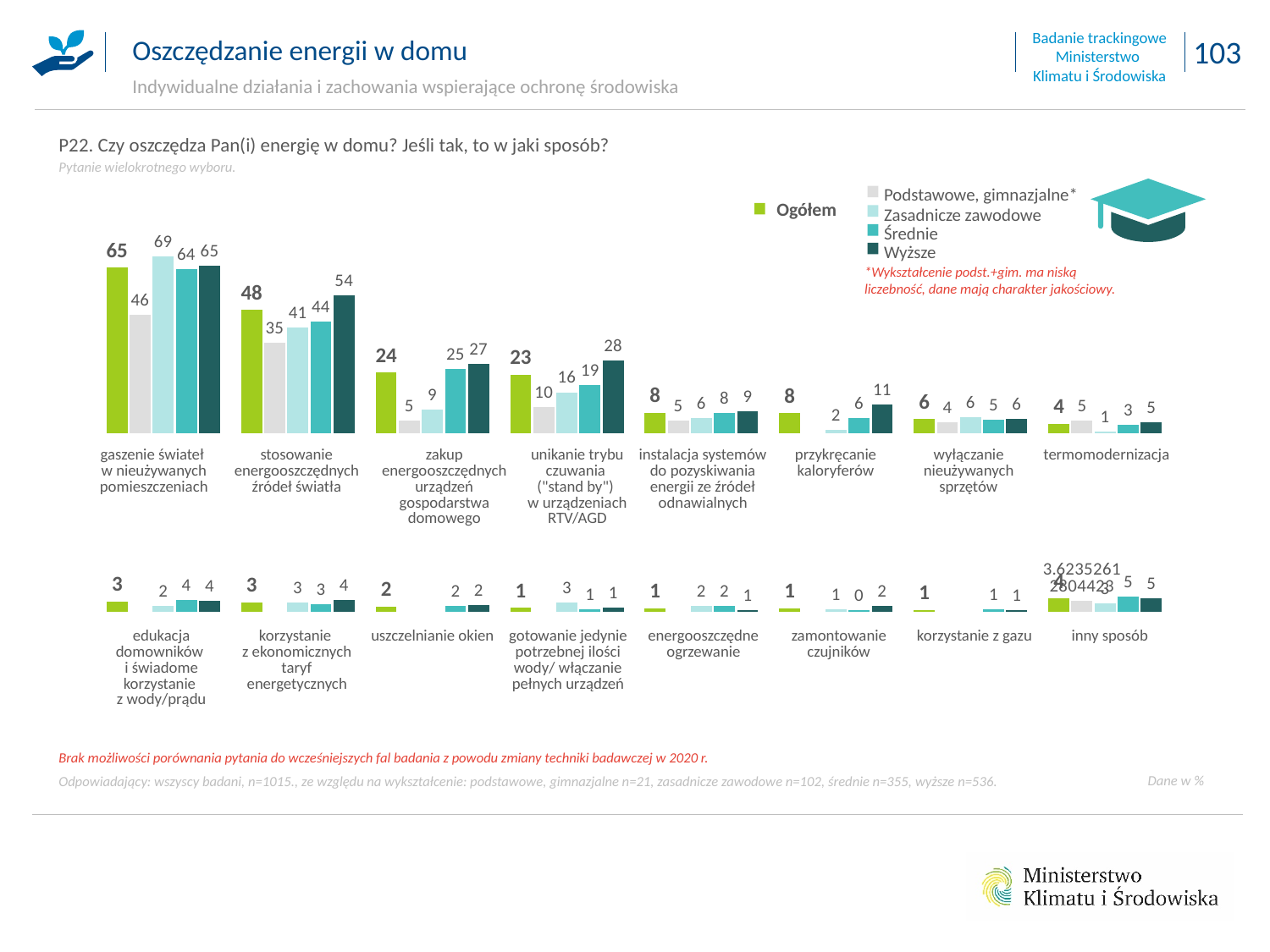
What is the Ogółem value for 'gaszenie świateł w nieużywanych pomieszczeniach'? 65 What is the difference between the Wyższe and Podstawowe, gimnazjalne values for 'stosowanie energooszczędnych źródeł światła'? 19 Which category has the highest Ogółem value? gaszenie świateł w nieużywanych pomieszczeniach What is the Wyższe value for 'stosowanie energooszczędnych źródeł światła'? 54 What is the difference between the Ogółem values for 'gaszenie świateł w nieużywanych pomieszczeniach' and 'stosowanie energooszczędnych źródeł światła'? 17 What is the Podstawowe, gimnazjalne value for 'zakup energooszczędnych urządzeń gospodarstwa domowego'? 5 What kind of chart is shown on the slide? bar chart Within 'stosowanie energooszczędnych źródeł światła', which education group has the lowest value? Podstawowe, gimnazjalne How many series does the legend list? 5 Which legend entry is marked with an asterisk? Podstawowe, gimnazjalne What is the Zasadnicze zawodowe value for 'gaszenie świateł w nieużywanych pomieszczeniach'? 69 For 'unikanie trybu czuwania', which is larger: the Wyższe value or the Podstawowe, gimnazjalne value? Wyższe